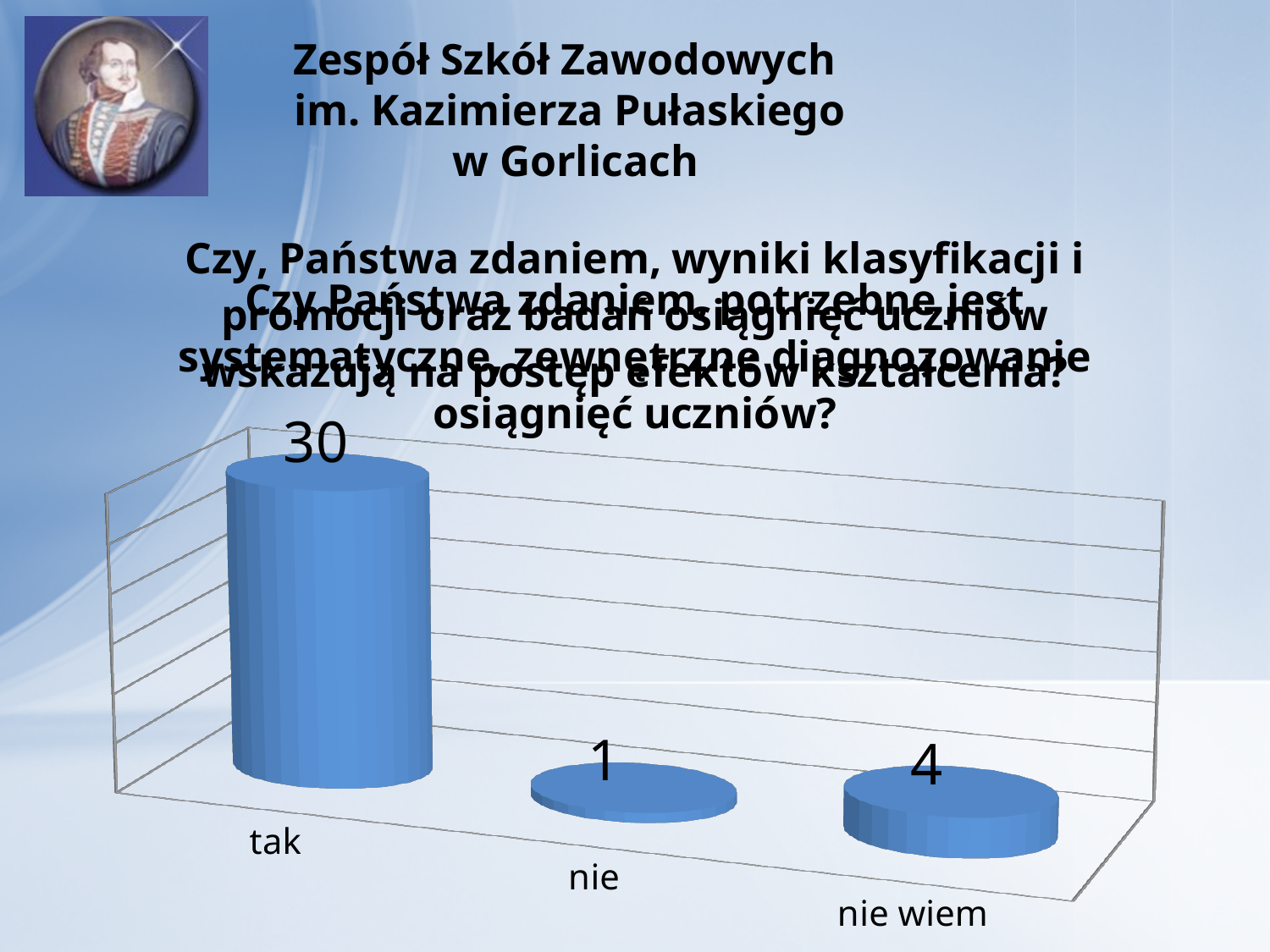
What is the value for "tak"? 30 What is the value for "nie"? 1 Which category has the highest value? tak What kind of chart is shown on the slide? bar chart What colour are the bars in the chart? blue How many categories are shown in the chart? 3 What is the difference between the values for "nie wiem" and "nie"? 3 What is the total of all three values shown in the chart? 35 Which is larger, the value for "nie" or the value for "nie wiem"? nie wiem What is the difference between the values for "tak" and "nie wiem"? 26 What is the value for "nie wiem"? 4 Which category has the lowest value? nie